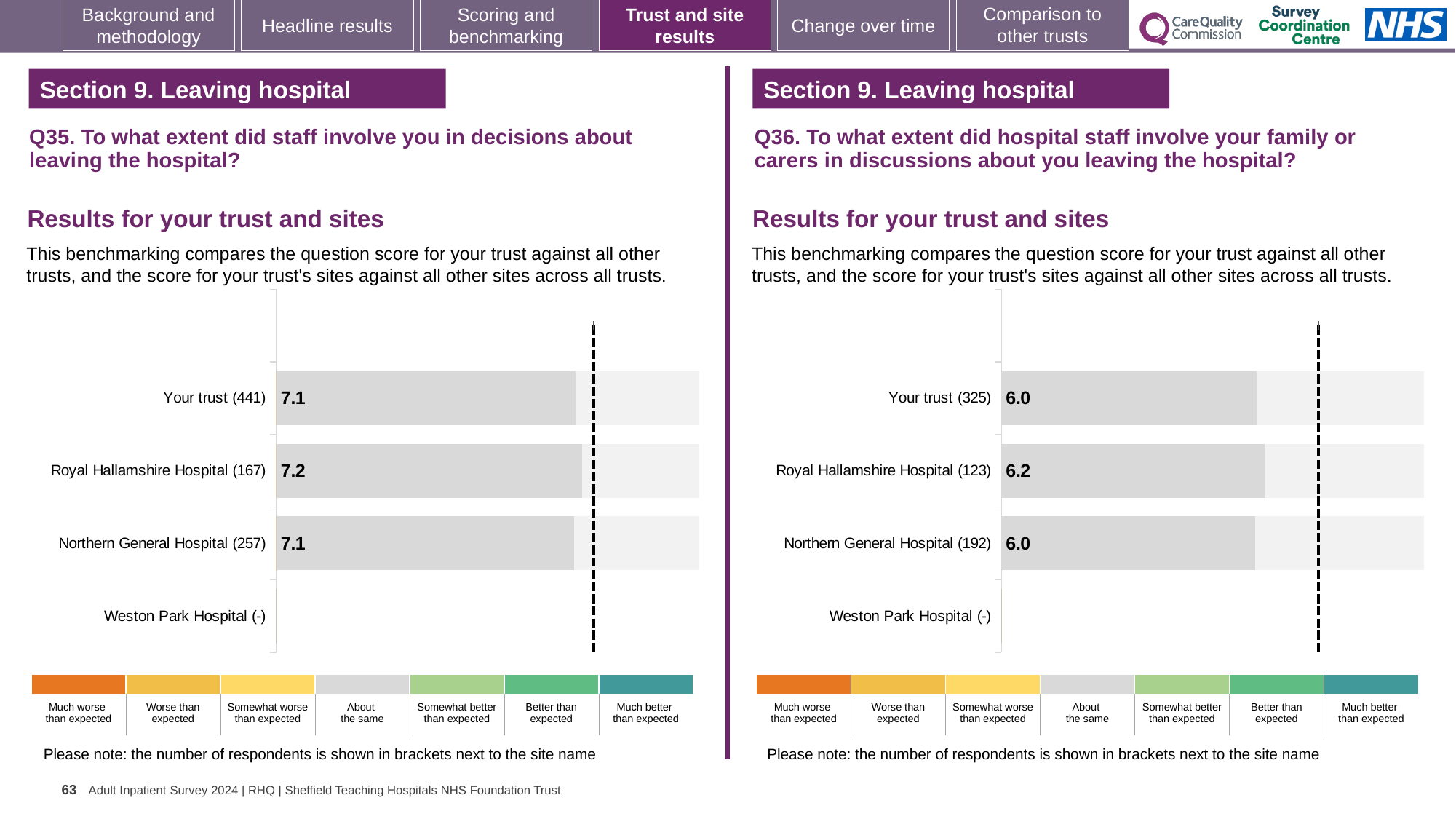
In the Q35 chart on the left, how many respondents are shown in brackets for Northern General Hospital? 257 In the Q35 chart on the left, what is the score for Your trust? 7.1 In the Q35 chart on the left, which site has the highest score? Royal Hallamshire Hospital In the Q35 chart on the left, which site has no score shown (marked with a dash)? Weston Park Hospital In the Q36 chart on the right, how many respondents are shown in brackets for Your trust? 325 How many row labels (sites including Your trust) are listed in the Q35 chart on the left? 4 In the Q36 chart on the right, what is the difference between the Royal Hallamshire Hospital score and the Your trust score? 0.2 In the Q36 chart on the right, what is the score for Royal Hallamshire Hospital? 6.2 In the Q35 chart on the left, what is the score for Royal Hallamshire Hospital? 7.2 What kind of chart is used in the Q36 chart on the right? Bar chart In the Q36 chart on the right, what is the score for Northern General Hospital? 6.0 In the Q35 chart on the left, which is larger: the score for Royal Hallamshire Hospital or the score for Northern General Hospital? Royal Hallamshire Hospital